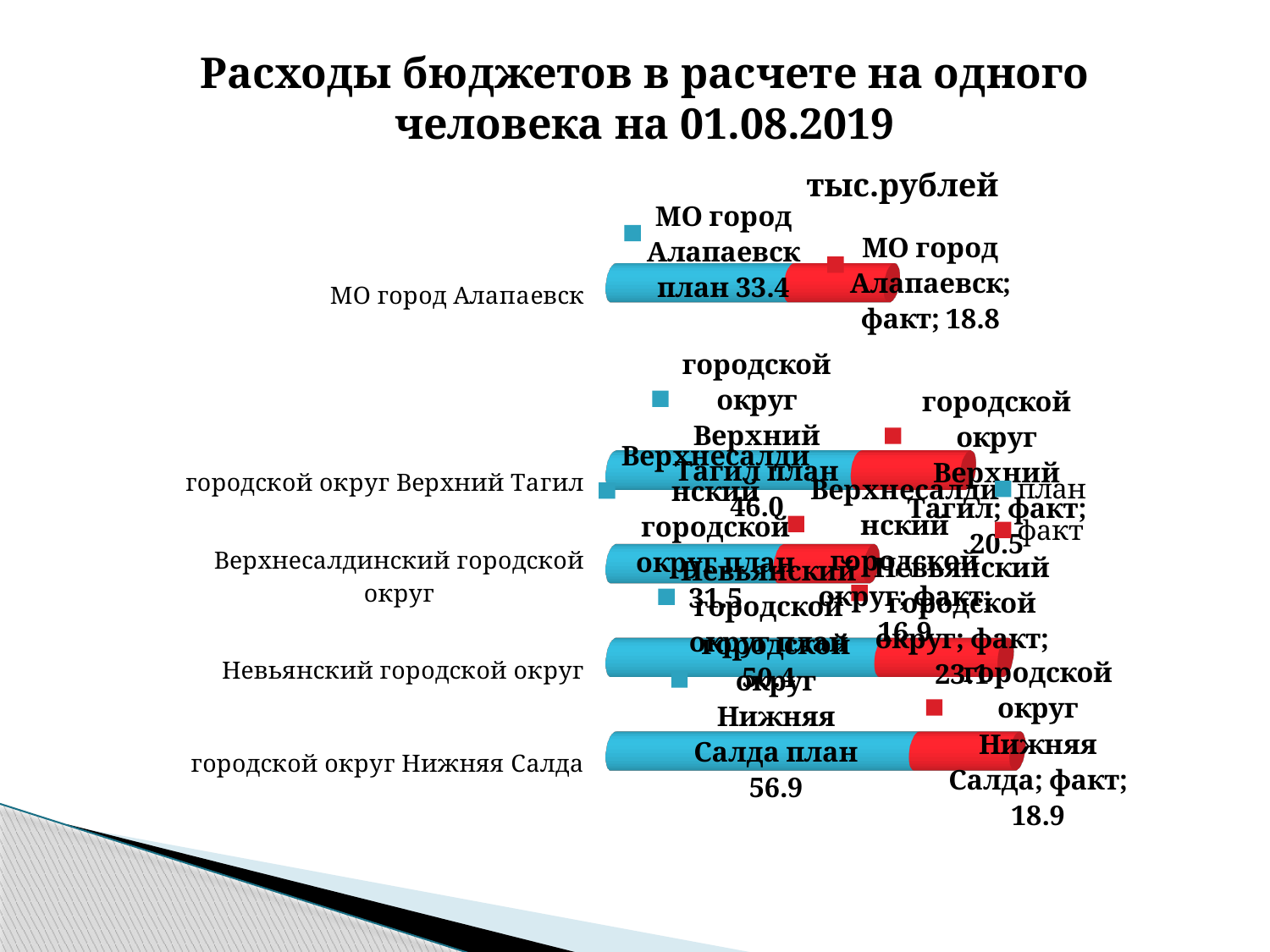
What is the план value for Невьянский городской округ? 50.4 What is the факт value for городской округ Нижняя Салда? 18.9 Which is larger: the план value for городской округ Нижняя Салда or the план value for Невьянский городской округ? городской округ Нижняя Салда What is the план value for МО город Алапаевск? 33.4 What is the факт value for МО город Алапаевск? 18.8 Which category has the lowest план value? Верхнесалдинский городской округ Which category has the highest план value? городской округ Нижняя Салда What is the difference between the план and факт values for МО город Алапаевск? 14.6 How many categories are shown on the chart? 5 What type of chart is shown on the slide? Stacked bar chart What is the план value for городской округ Нижняя Салда? 56.9 How many series does the legend list? 2